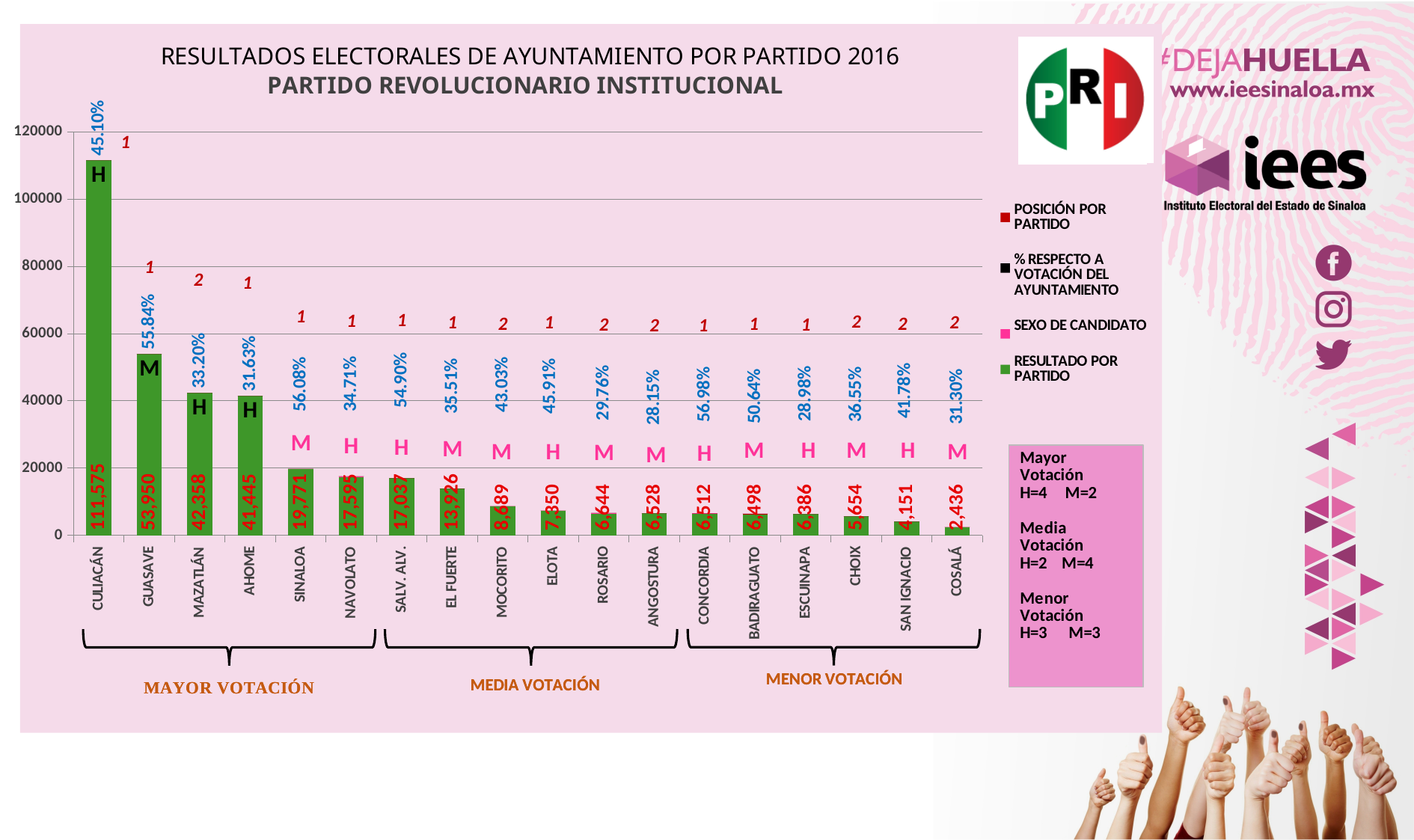
How many entries does the legend list? 4 Do the vote counts rise or fall from left to right along the x axis? Fall What kind of chart is this? Bar chart What percentage is shown for Guasave? 55.84% Which municipality has the highest vote count? Culiacán What is the difference between the vote counts for Culiacán and Guasave? 57,625 Which has a larger vote count, Sinaloa or Navolato? Sinaloa Is the value for Culiacán greater or less than 100000? greater What is the vote count for Culiacán? 111,575 How many municipalities are shown on the x axis? 18 Which municipality has the lowest vote count? Cosalá What is the vote count for Mazatlán? 42,358